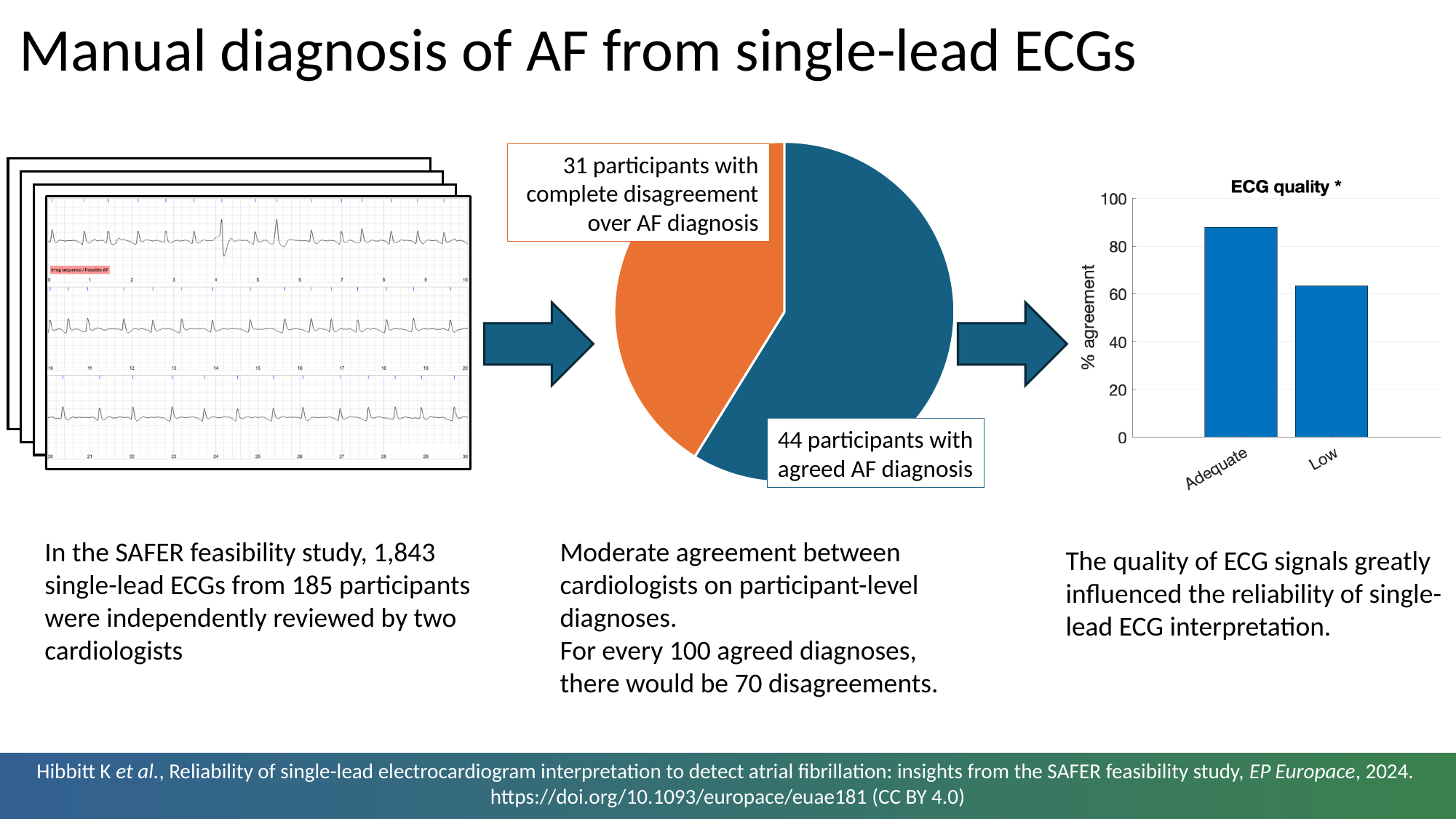
What type of chart is the 'ECG quality *' chart on the right of the slide? Bar chart What is the y-axis label of the 'ECG quality *' chart? % agreement In the pie chart, what is the difference between the number of participants with agreed AF diagnosis and those with complete disagreement? 13 In the pie chart, what is the total number of participants across both slices? 75 In the 'ECG quality *' chart, is the value for Low greater or less than 80? less In the pie chart, how many participants had an agreed AF diagnosis? 44 In the pie chart, what colour is the slice for participants with complete disagreement over AF diagnosis? Orange In the pie chart, how many participants had complete disagreement over AF diagnosis? 31 In the pie chart, which group is larger: participants with agreed AF diagnosis or participants with complete disagreement? Participants with agreed AF diagnosis In the 'ECG quality *' chart, which category has the highest % agreement? Adequate In the 'ECG quality *' chart, is the value for Adequate greater or less than 80? greater How many slices does the pie chart in the middle of the slide have? 2